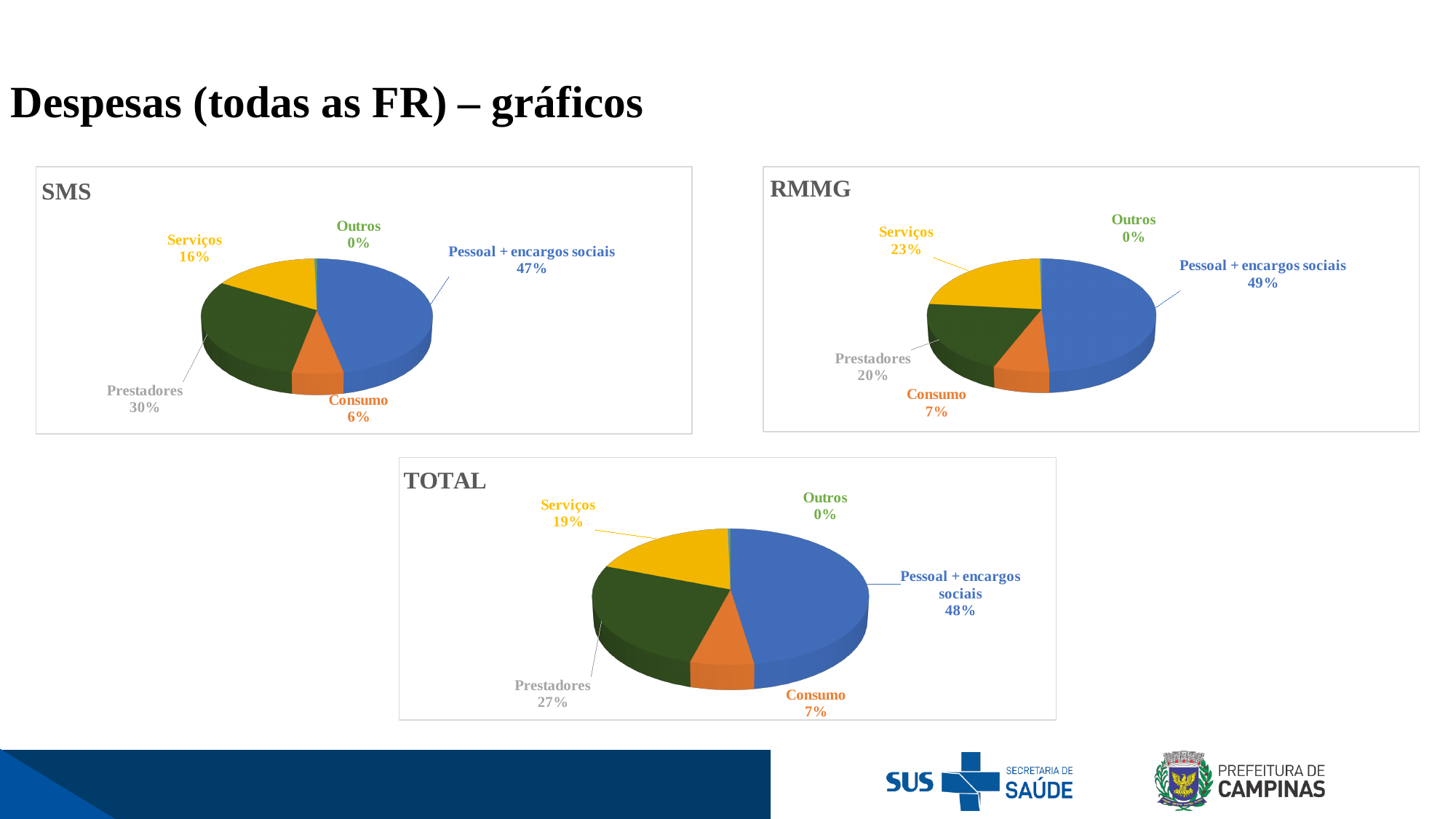
In the SMS chart, which category has the largest share? Pessoal + encargos sociais How many categories are shown in the TOTAL chart? 5 In the RMMG chart, which category has the smallest share? Outros In the SMS chart, what share does Consumo have? 6% What kind of chart is the RMMG chart? Pie chart In the TOTAL chart, what is the difference between the shares of Pessoal + encargos sociais and Serviços? 29% In the SMS chart, which is larger: the share of Prestadores or the share of Serviços? Prestadores In the TOTAL chart, what share does Prestadores have? 27% In the RMMG chart, what is the difference between the shares of Prestadores and Consumo? 13% In the SMS chart, what share does Pessoal + encargos sociais have? 47% In the RMMG chart, what share does Serviços have? 23% How many charts are on the slide? 3